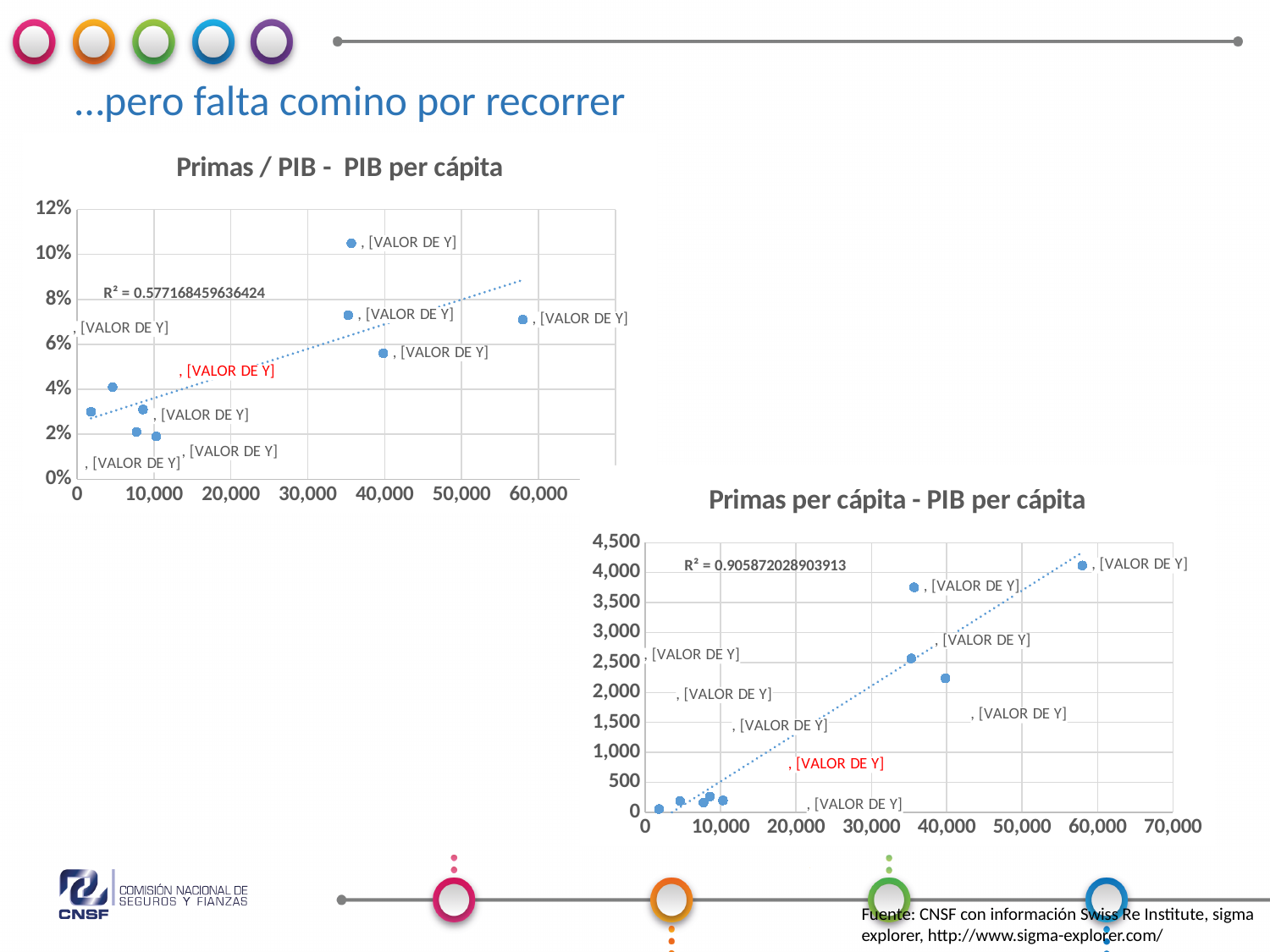
In the 'Primas per cápita - PIB per cápita' chart, do the values generally rise or fall along the x axis? rise In the 'Primas per cápita - PIB per cápita' chart, is the point at roughly 40,000 on the x axis greater or less than 2,500? less In the 'Primas / PIB - PIB per cápita' chart, is the highest plotted point greater or less than 10%? greater In the 'Primas / PIB - PIB per cápita' chart, do the values generally rise or fall as PIB per cápita increases along the x axis? rise Which chart shows the higher R² value, 'Primas / PIB - PIB per cápita' or 'Primas per cápita - PIB per cápita'? Primas per cápita - PIB per cápita What is the maximum value shown on the x axis of the 'Primas per cápita - PIB per cápita' chart? 70,000 In the 'Primas per cápita - PIB per cápita' chart, is the highest plotted point greater or less than 4,000? greater What kind of chart is the 'Primas per cápita - PIB per cápita' chart? scatter chart In the 'Primas / PIB - PIB per cápita' chart, what R² value is printed? R² = 0.577168459636424 What kind of chart is the 'Primas / PIB - PIB per cápita' chart? scatter chart What is the maximum value shown on the y axis of the 'Primas / PIB - PIB per cápita' chart? 12% In the 'Primas per cápita - PIB per cápita' chart, what R² value is printed? R² = 0.905872028903913